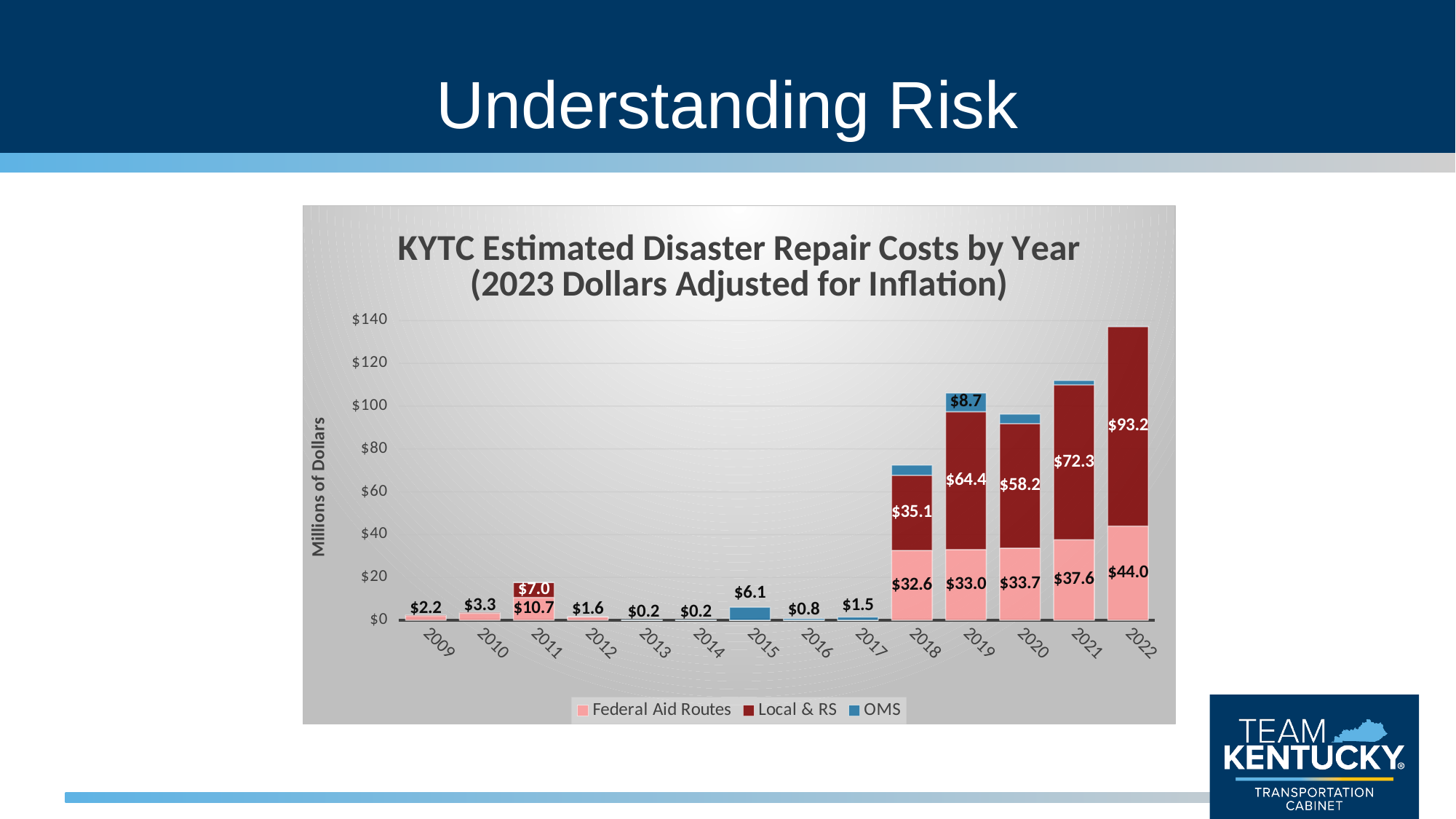
Which year has the highest Federal Aid Routes value? 2022 What is the difference between the Local & RS values for 2022 and 2021? $20.9 Do the Federal Aid Routes values rise or fall from 2018 to 2022? Rise What is the OMS value for 2019? $8.7 What is the Federal Aid Routes value for 2019? $33.0 What is the total of the stacked bar for 2011? $17.7 How many years are shown on the x axis? 14 Is the total bar height for 2022 greater or less than $120? greater How many series does the legend list? 3 What is the Local & RS value for 2022? $93.2 What kind of chart is shown on the slide? Stacked bar chart Which year has the larger Local & RS value, 2019 or 2020? 2019